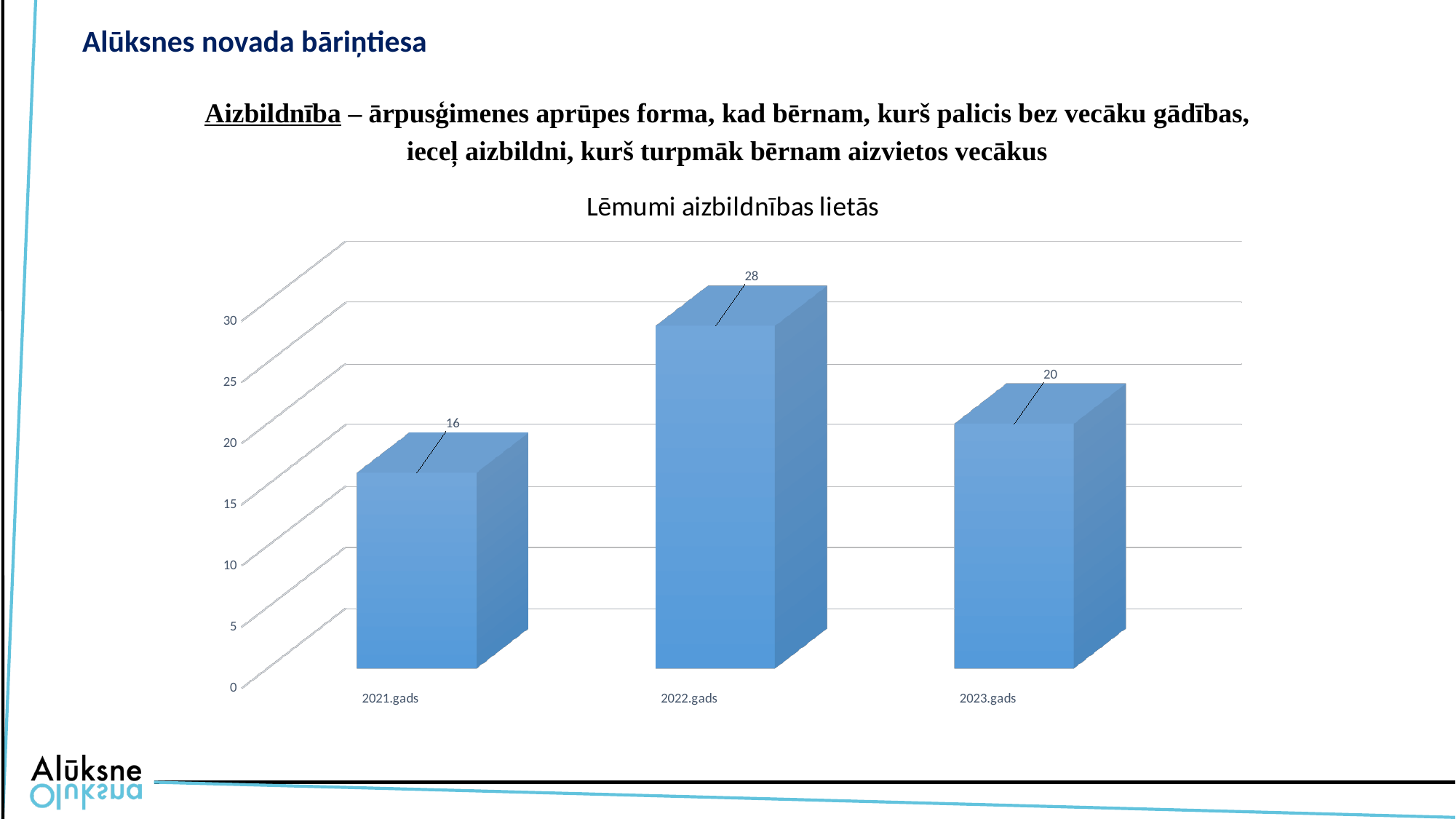
Which year has the highest value? 2022.gads What is the title of the chart? Lēmumi aizbildnības lietās What is the value for 2023.gads? 20 What is the difference between the values for 2022.gads and 2021.gads? 12 How many years are shown on the chart? 3 Which year has the lowest value? 2021.gads What is the difference between the values for 2022.gads and 2023.gads? 8 What is the value for 2021.gads? 16 What is the value for 2022.gads? 28 Which is larger, the value for 2023.gads or the value for 2021.gads? 2023.gads Is the value for 2022.gads greater or less than 25? greater What kind of chart is shown on the slide? bar chart